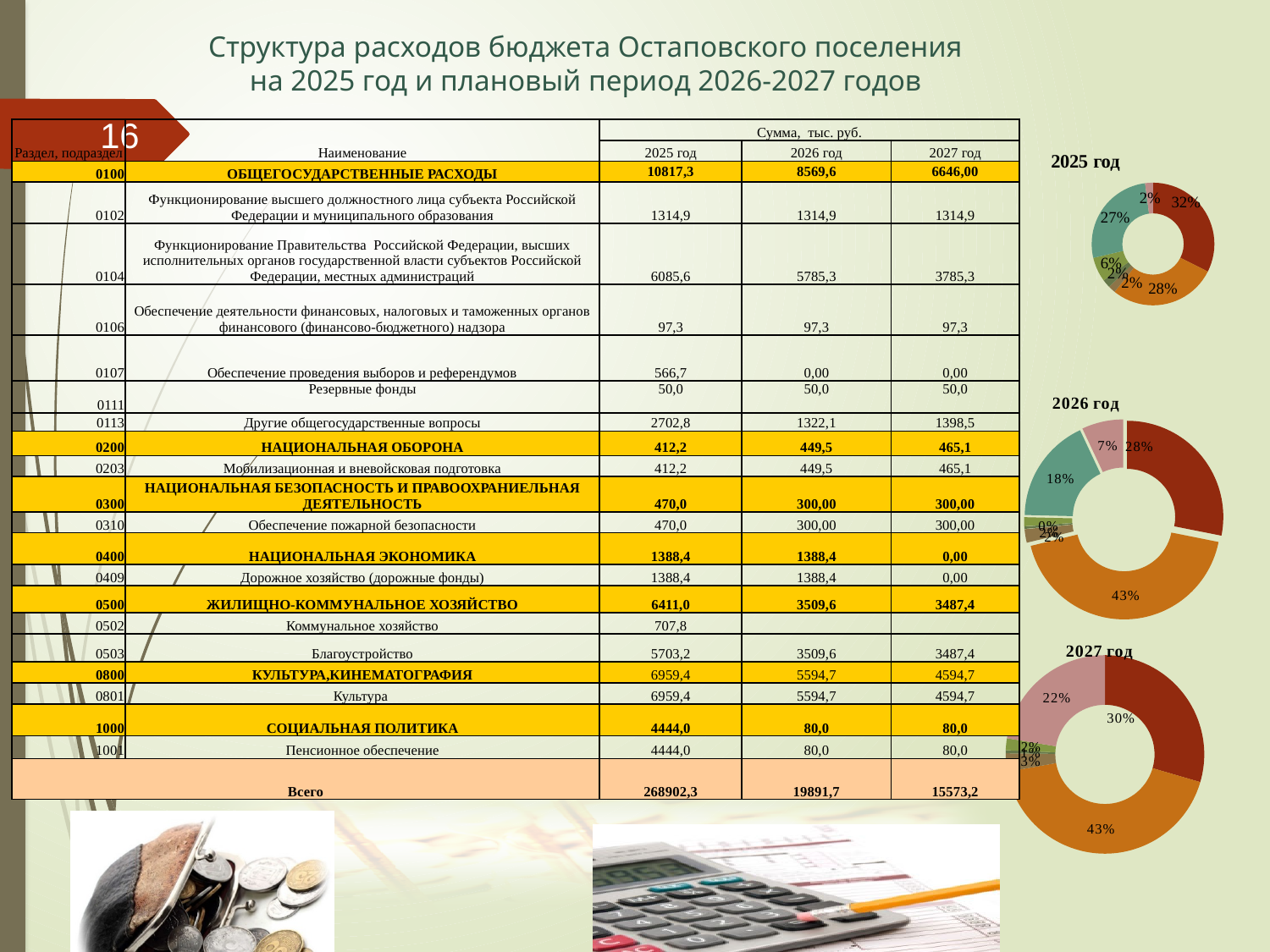
How many charts are shown on the slide? 3 In the chart titled "2027 год", what is the percentage of the largest slice? 43% In the chart titled "2027 год", is the largest slice greater or less than 40%? greater In the chart titled "2026 год", what is the percentage of the second-largest slice? 28% In the chart titled "2025 год", what is the percentage of the largest slice? 32% In the chart titled "2025 год", is the largest slice greater or less than 40%? less In the chart titled "2026 год", what is the percentage of the largest slice? 43% What are the titles of the three charts on the slide? 2025 год, 2026 год, 2027 год What kind of chart is the chart titled "2027 год"? doughnut chart Which chart has a larger largest slice: "2025 год" or "2026 год"? 2026 год What kind of chart is the chart titled "2025 год"? doughnut chart In the chart titled "2027 год", what is the percentage of the second-largest slice? 30%